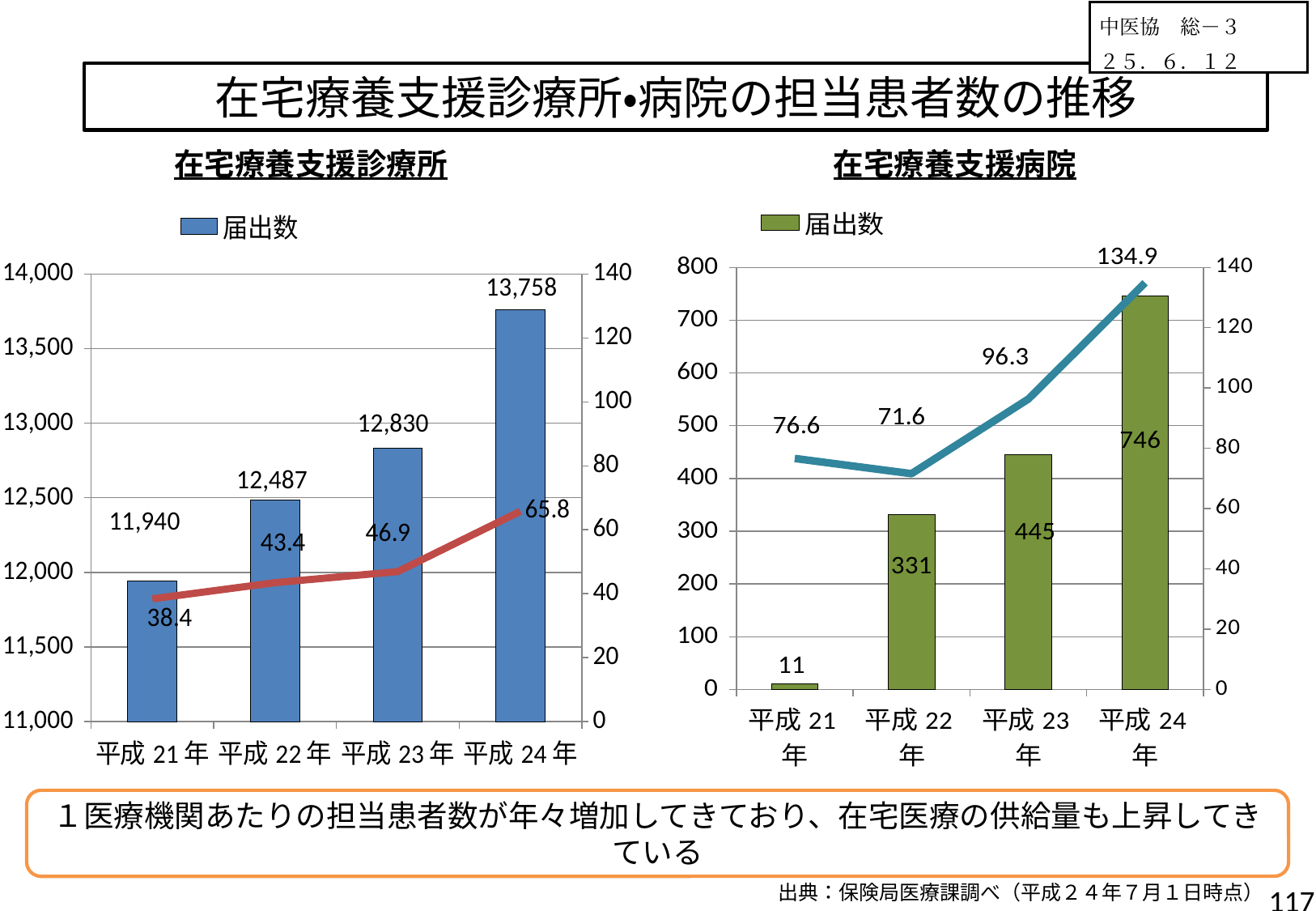
In the 在宅療養支援病院 chart on the right, which year has the highest 届出数? 平成24年 In the 在宅療養支援診療所 chart on the left, what is the difference in 届出数 between 平成24年 and 平成23年? 928 In the 在宅療養支援診療所 chart on the left, what is the 届出数 value for 平成24年? 13,758 In the 在宅療養支援病院 chart on the right, how many years are shown on the x axis? 4 How many entries does the legend of the 在宅療養支援診療所 chart on the left list? 1 In the 在宅療養支援診療所 chart on the left, do the 届出数 bars rise or fall from 平成21年 to 平成24年? rise In the 在宅療養支援病院 chart on the right, what is the line value labelled for 平成24年? 134.9 In the 在宅療養支援病院 chart on the right, what is the difference in 届出数 between 平成24年 and 平成23年? 301 In the 在宅療養支援病院 chart on the right, what is the 届出数 value for 平成22年? 331 In the 在宅療養支援病院 chart on the right, which year has the lowest 届出数? 平成21年 In the 在宅療養支援診療所 chart on the left, what is the line value labelled for 平成23年? 46.9 In the 在宅療養支援診療所 chart on the left, what is the 届出数 value for 平成21年? 11,940